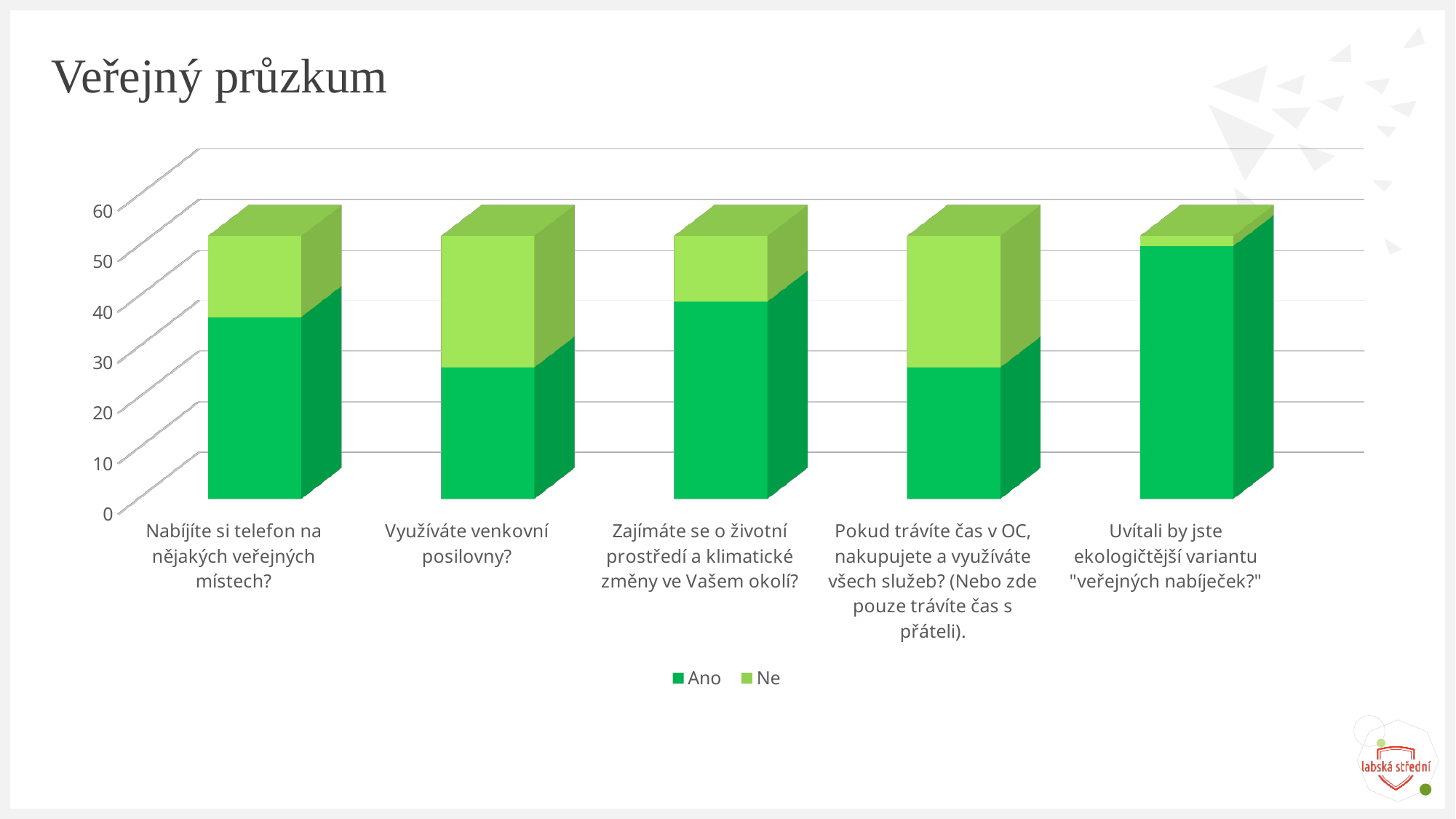
Which has the larger "Ne" value: "Využíváte venkovní posilovny?" or "Zajímáte se o životní prostředí a klimatické změny ve Vašem okolí?" Využíváte venkovní posilovny? Is the "Ano" value for "Uvítali by jste ekologičtější variantu "veřejných nabíječek?"" greater or less than 40? greater Which category has the lowest "Ne" value? Uvítali by jste ekologičtější variantu "veřejných nabíječek?" Which has the larger "Ano" value: "Nabíjíte si telefon na nějakých veřejných místech?" or "Využíváte venkovní posilovny?" Nabíjíte si telefon na nějakých veřejných místech? Is the "Ano" value for "Nabíjíte si telefon na nějakých veřejných místech?" greater or less than 30? greater What is the title of the slide containing the chart? Veřejný průzkum How many survey questions (categories) are shown on the x axis of the chart? 5 What kind of chart is shown on the slide? stacked bar chart Which two entries appear in the chart legend? Ano and Ne How many series does the chart legend list? 2 Is the "Ano" value for "Využíváte venkovní posilovny?" greater or less than 40? less Which category has the highest "Ano" value? Uvítali by jste ekologičtější variantu "veřejných nabíječek?"